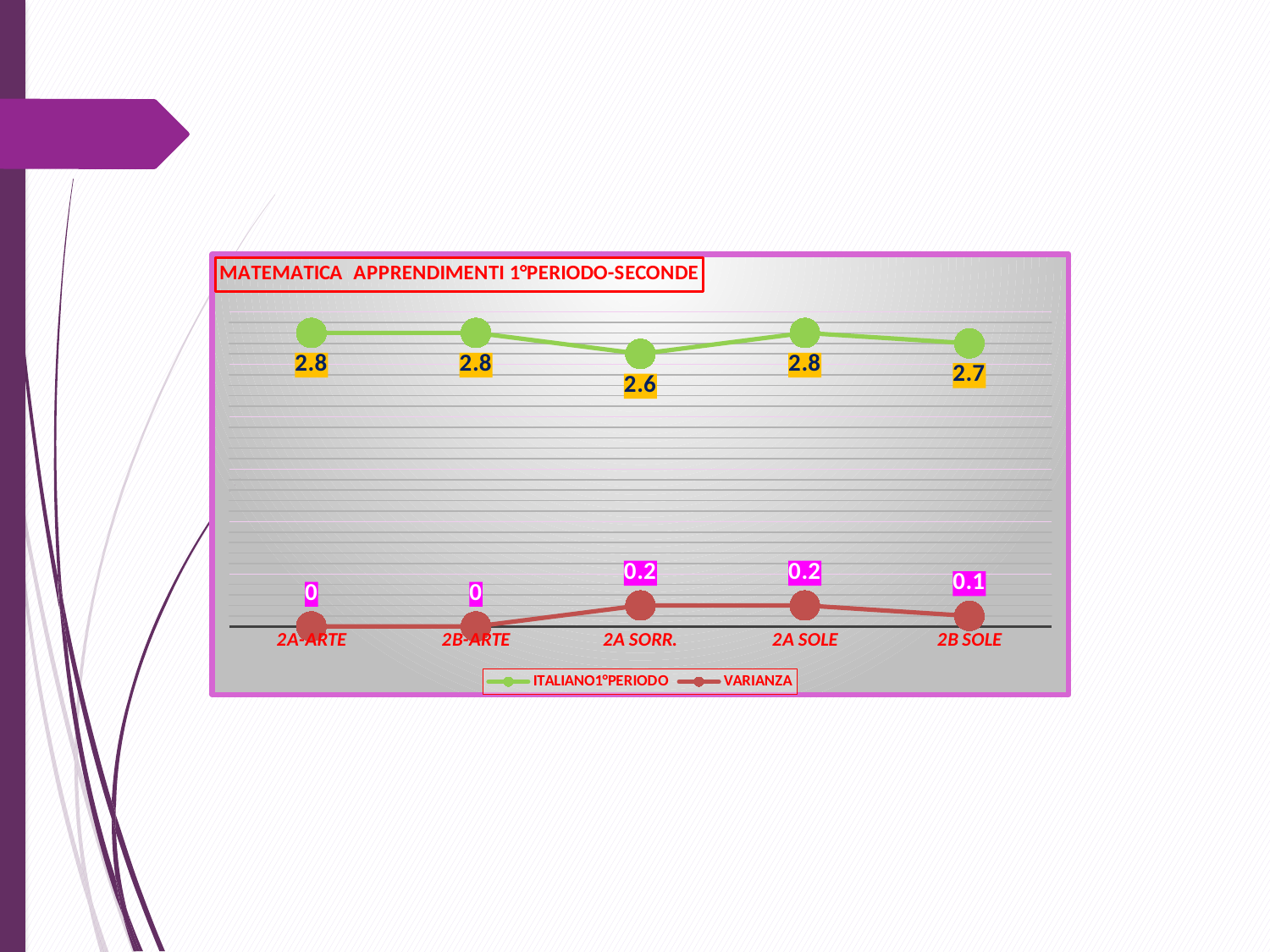
Which series is drawn in green? ITALIANO1°PERIODO What is the ITALIANO1°PERIODO value for 2B SOLE? 2.7 What is the ITALIANO1°PERIODO value for 2A SORR.? 2.6 Which category has the lowest ITALIANO1°PERIODO value? 2A SORR. What is the difference between the ITALIANO1°PERIODO values for 2A ARTE and 2A SORR.? 0.2 How many categories are shown on the x axis? 5 What is the title of the chart? MATEMATICA APPRENDIMENTI 1°PERIODO-SECONDE What is the VARIANZA value for 2B SOLE? 0.1 Which is larger, the VARIANZA value for 2A SOLE or for 2B SOLE? 2A SOLE How many series does the legend list? 2 What is the VARIANZA value for 2A ARTE? 0 What kind of chart is shown on the slide? Line chart